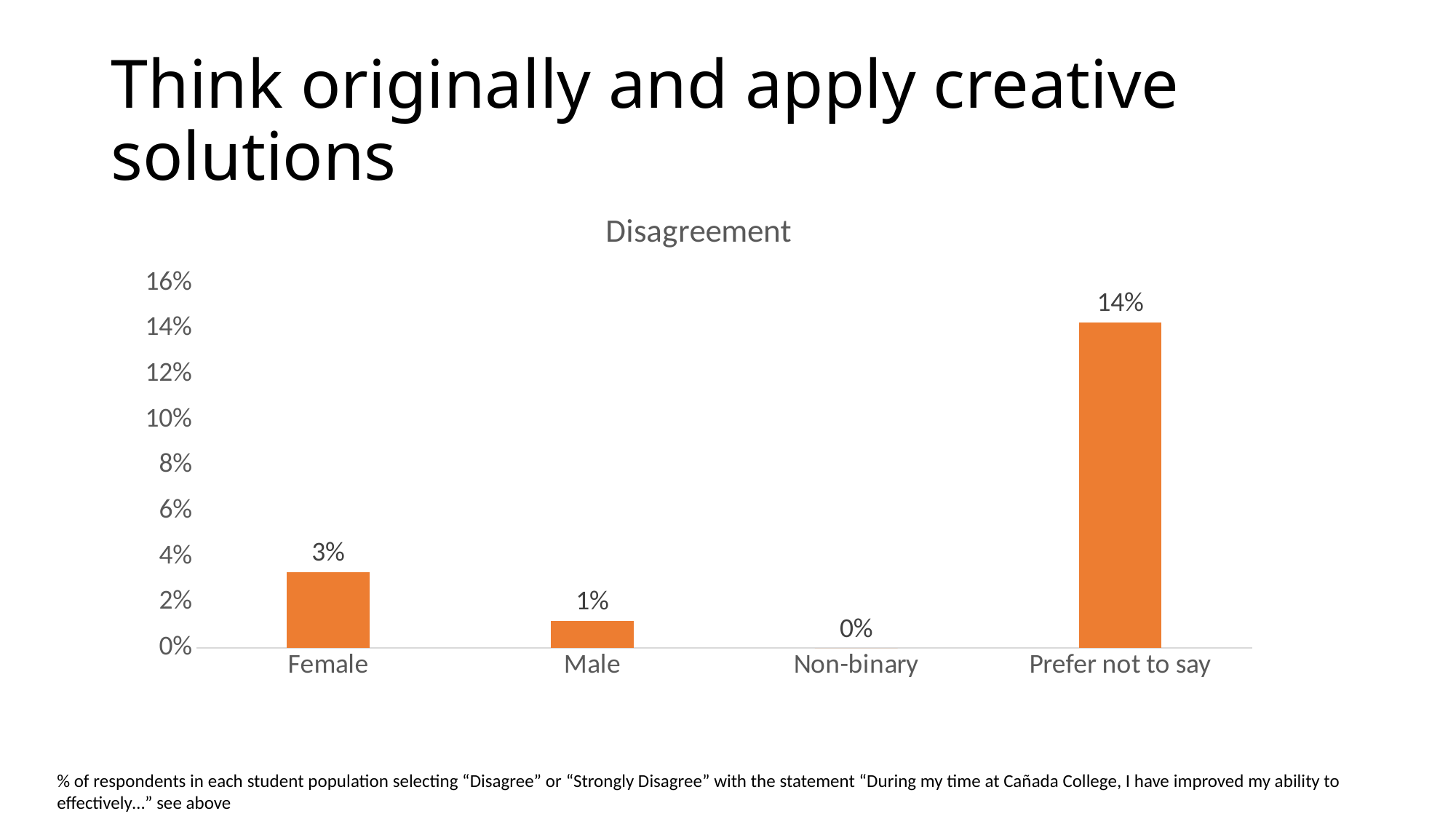
How many categories are shown on the x axis? 4 What is the value for Female? 3% Which is larger, the value for Female or the value for Male? Female What is the value for Male? 1% What is the value for Non-binary? 0% Is the value for Prefer not to say greater or less than 10%? greater What is the title of the chart? Disagreement What kind of chart is shown on the slide? bar chart What is the value for Prefer not to say? 14% What is the difference between the values for Prefer not to say and Female? 11% Which category has the highest value? Prefer not to say Which category has the lowest value? Non-binary